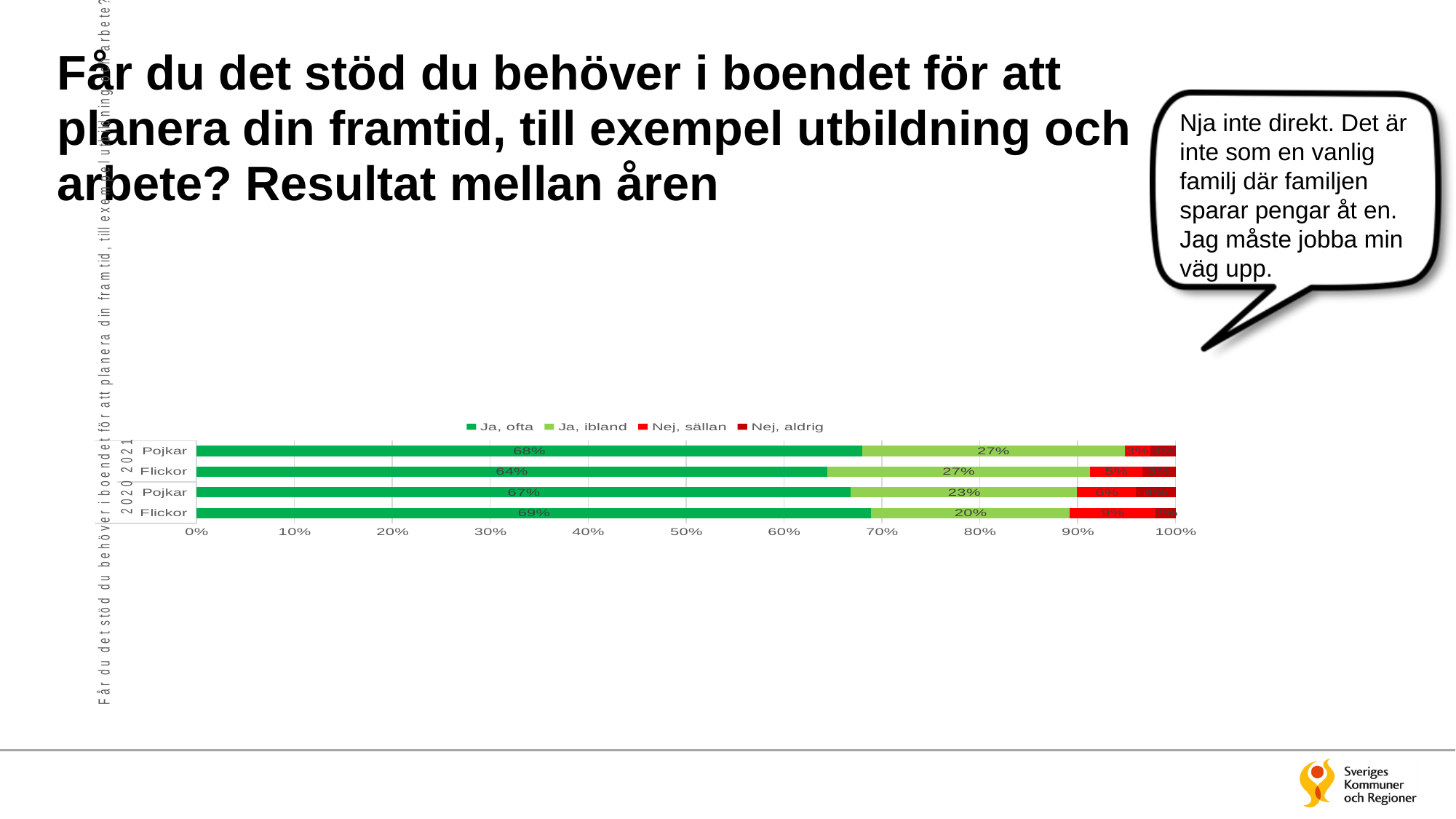
What is the difference between the 'Ja, ofta' values for Pojkar 2021 and Flickor 2021? 4 percentage points Which category has the highest 'Ja, ofta' value? Flickor 2020 What is the 'Nej, sällan' value for Flickor in 2020? 9% How many series does the legend list? 4 What kind of chart is shown on the slide? stacked bar chart How many category bars are plotted in the chart? 4 Is the 'Ja, ibland' value larger for Pojkar 2020 or Flickor 2020? Pojkar 2020 What is the 'Ja, ibland' value for Flickor in 2020? 20% What is the 'Ja, ofta' value for Pojkar in 2021? 68% What is the 'Ja, ofta' value for Flickor in 2021? 64% Which legend entry is shown in light green? Ja, ibland Which category has the lowest 'Ja, ibland' value? Flickor 2020